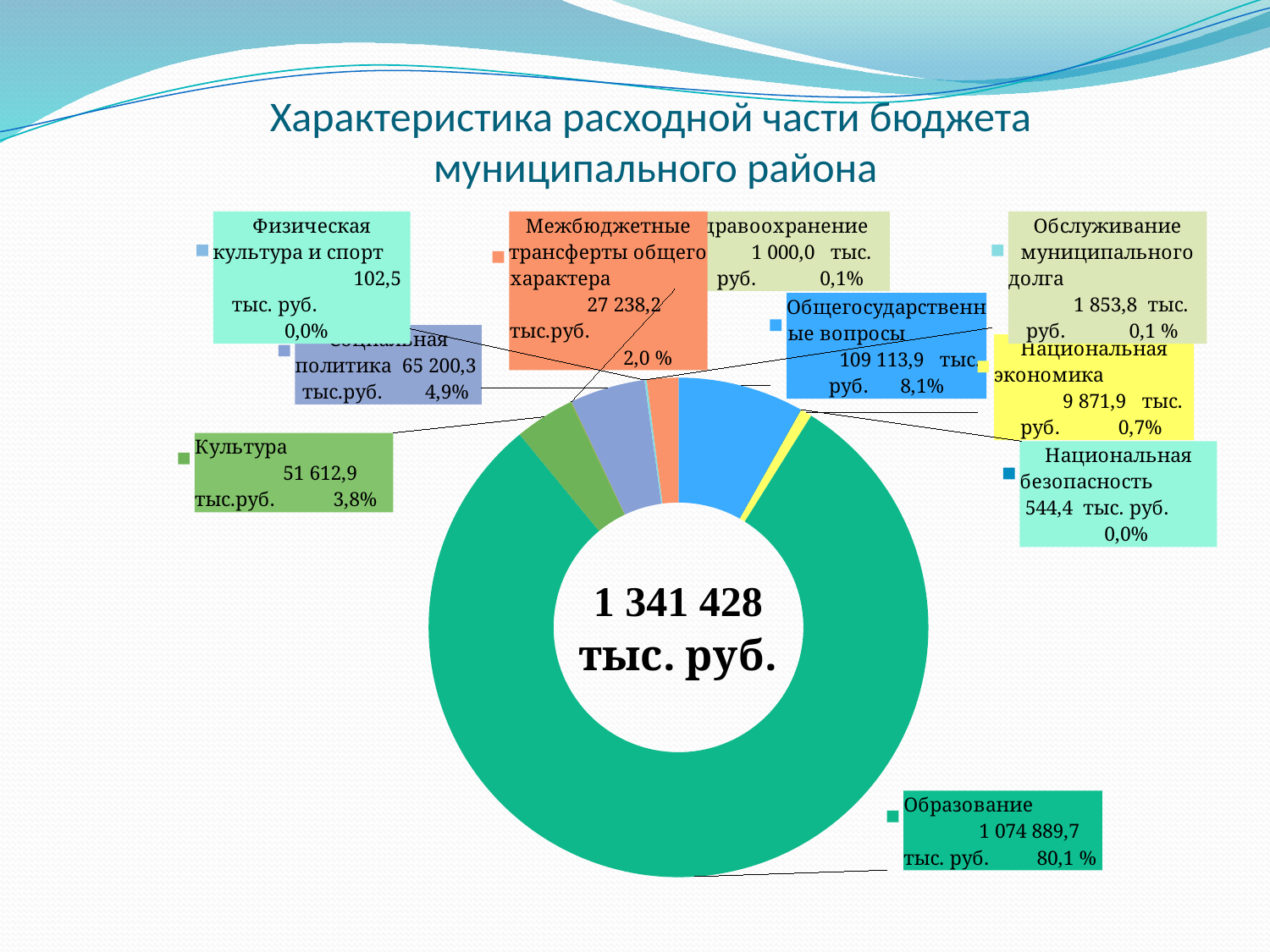
What is the value for Культура? 51 612,9 тыс.руб. Which category has the smallest value? Физическая культура и спорт How many categories are shown in the chart? 10 What is the value for Образование? 1 074 889,7 тыс. руб. Which category has the largest share of expenditure? Образование Which is larger: Межбюджетные трансферты общего характера or Национальная экономика? Межбюджетные трансферты общего характера What share does Социальная политика have? 4,9% What total value is printed in the centre of the doughnut chart? 1 341 428 тыс. руб. What kind of chart is shown on the slide? Doughnut (pie) chart What is the value for Общегосударственные вопросы? 109 113,9 тыс. руб. What is the share for Обслуживание муниципального долга? 0,1 % What share of the budget does Образование account for? 80,1 %